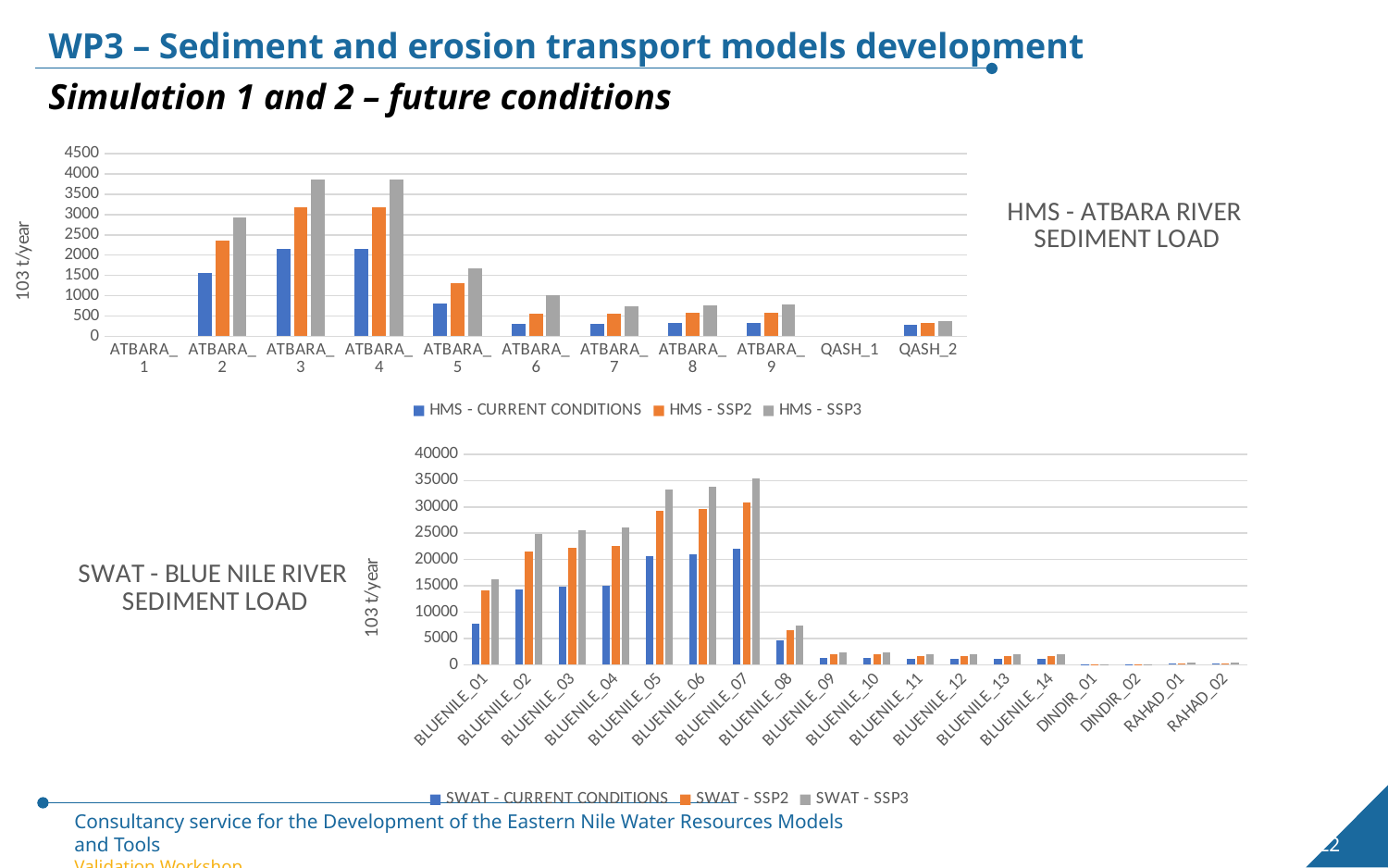
In the HMS - Atbara River Sediment Load chart, which is larger: the HMS - SSP3 value for ATBARA_2 or for ATBARA_5? ATBARA_2 In the SWAT - Blue Nile River Sediment Load chart, which category has the highest SWAT - SSP3 value? BLUENILE_07 How many categories are shown on the x axis of the SWAT - Blue Nile River Sediment Load chart? 18 How many categories are shown on the x axis of the HMS - Atbara River Sediment Load chart? 11 What kind of chart is the HMS - Atbara River Sediment Load chart at the top of the slide? Bar chart In the SWAT - Blue Nile River Sediment Load chart, is the SWAT - CURRENT CONDITIONS value for BLUENILE_01 greater or less than 10000? less In the HMS - Atbara River Sediment Load chart, is the HMS - CURRENT CONDITIONS value for ATBARA_6 greater or less than 500? less What unit is shown on the y axis of the SWAT - Blue Nile River Sediment Load chart? 103 t/year In the SWAT - Blue Nile River Sediment Load chart, is the SWAT - SSP3 value for BLUENILE_07 greater or less than 30000? greater How many series does the legend of the SWAT - Blue Nile River Sediment Load chart list? 3 How many series does the legend of the HMS - Atbara River Sediment Load chart list? 3